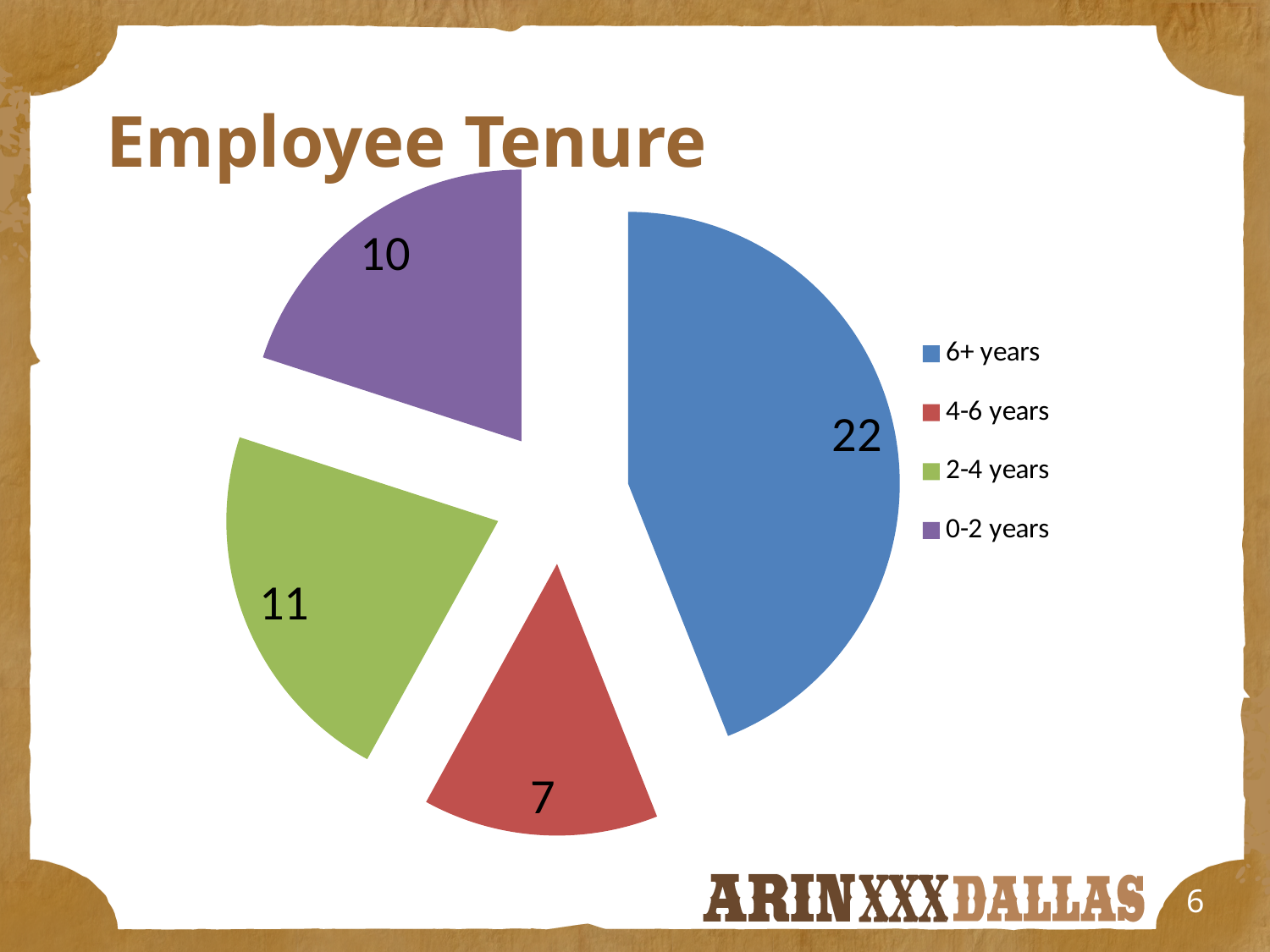
What type of chart is shown on the slide? Pie chart What is the value for the 0-2 years slice? 10 What is the value for the 4-6 years slice? 7 Which is larger, the 2-4 years slice or the 0-2 years slice? 2-4 years What is the value for the 6+ years slice? 22 What is the difference between the 6+ years value and the 2-4 years value? 11 What share of the pie does the 6+ years slice represent? 44% Which tenure category has the largest slice? 6+ years How many slices does the pie chart have? 4 What is the title of the chart? Employee Tenure What is the value for the 2-4 years slice? 11 Which tenure category has the smallest slice? 4-6 years